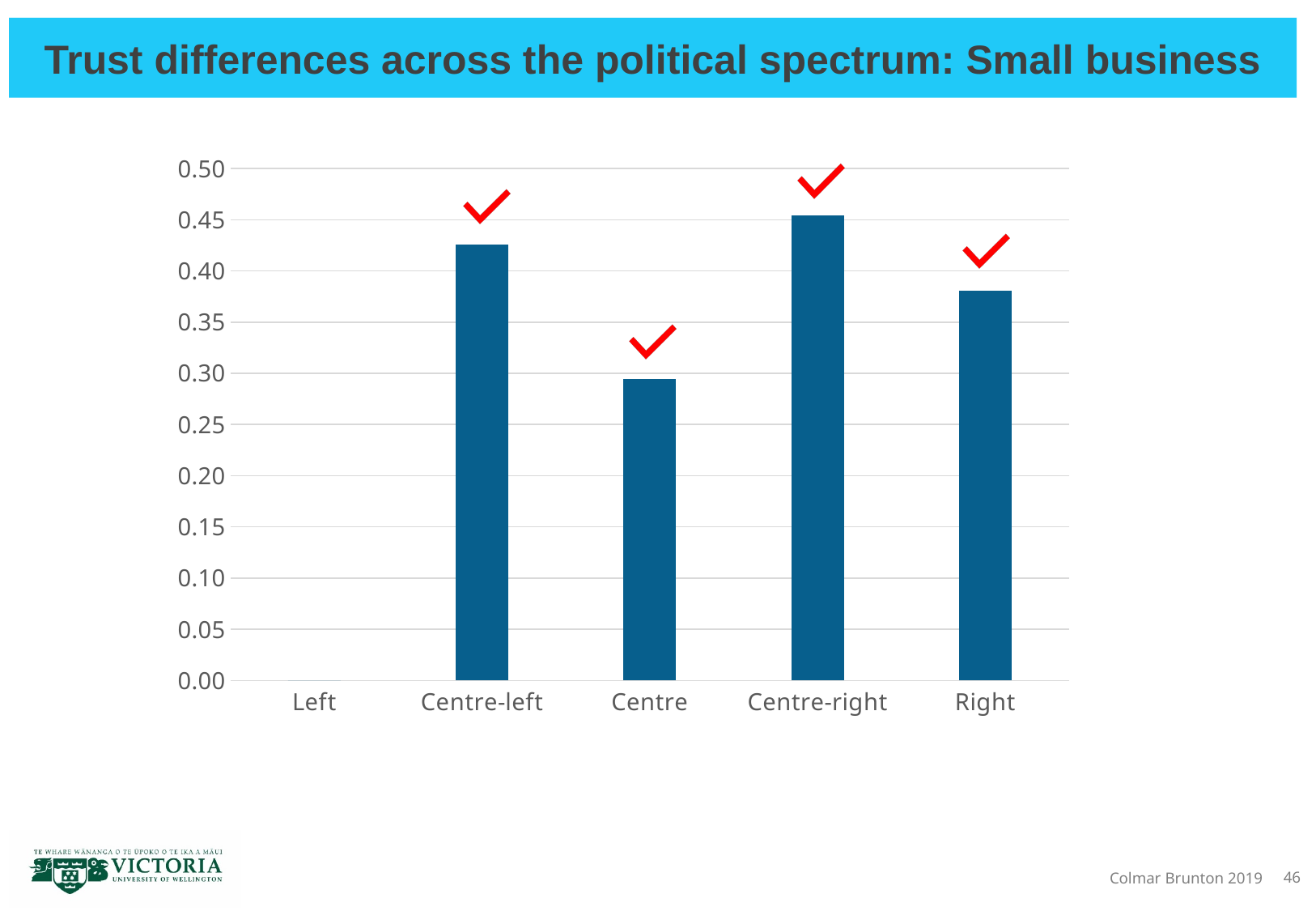
Which is larger, the value for Centre-left or the value for Right? Centre-left Which is larger, the value for Centre or the value for Right? Right What is the title of the slide? Trust differences across the political spectrum: Small business Which category has no red check mark above it? Left Which category has the highest value? Centre-right Among the categories with a visible bar, which has the lowest value? Centre Is the value for Right greater or less than 0.40? less How many categories are shown on the x axis? 5 What kind of chart is shown on the slide? Bar chart Is the value for Centre-left greater or less than 0.40? greater